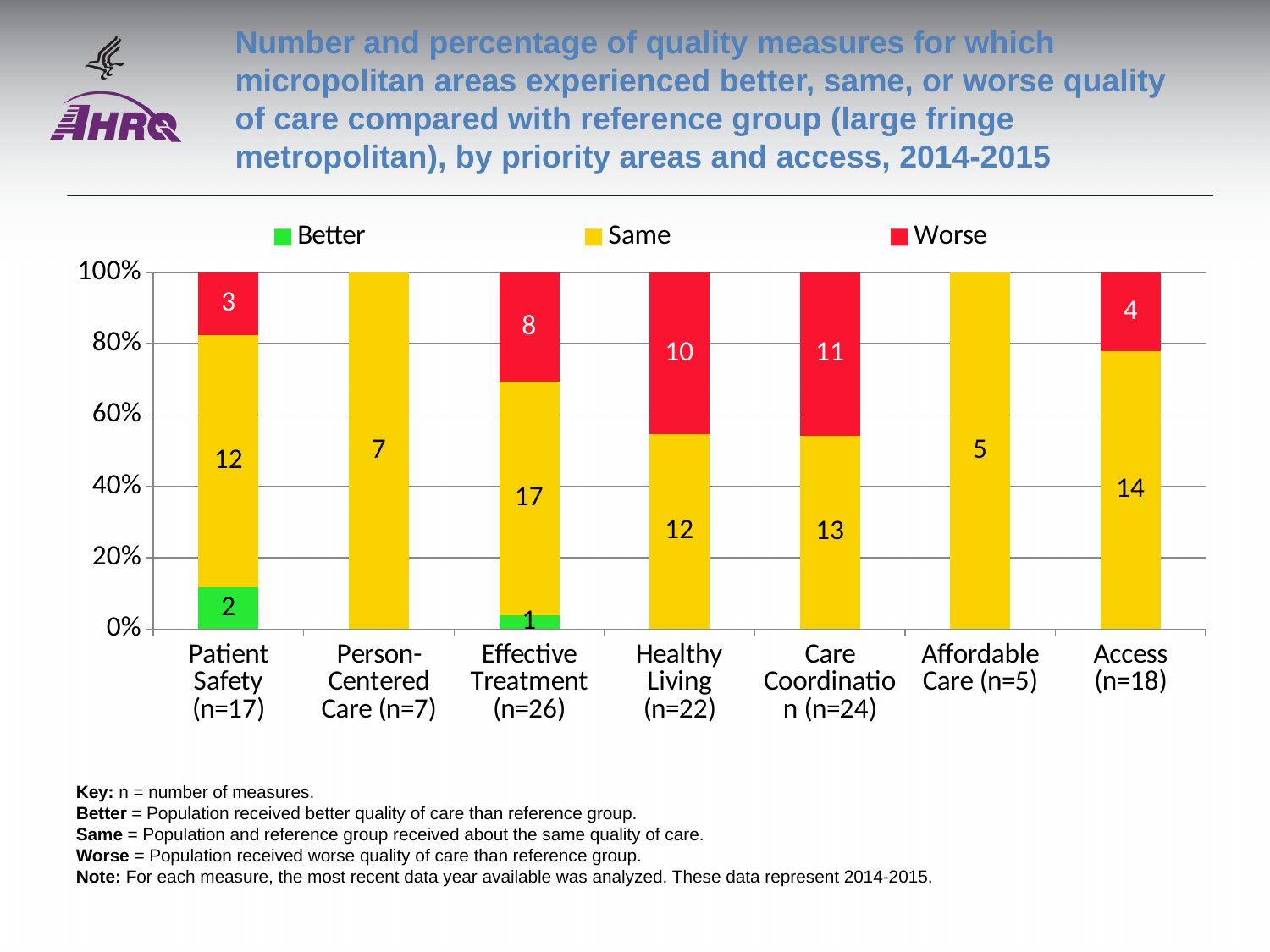
Which category has the lowest number of "Same" measures? Affordable Care (n=5) How many measures are labeled "Same" for Access (n=18)? 14 Which category has the highest number of "Worse" measures? Care Coordination (n=24) Which has more "Worse" measures, Healthy Living (n=22) or Access (n=18)? Healthy Living (n=22) How many measures are labeled "Better" for Patient Safety (n=17)? 2 What kind of chart is shown on the slide? Stacked bar chart How many categories are shown on the x axis? 7 How many measures are labeled "Worse" for Care Coordination (n=24)? 11 How many series does the legend list? 3 How many measures are labeled "Same" for Effective Treatment (n=26)? 17 Is the "Same" share of the Healthy Living (n=22) bar greater or less than 40%? greater What is the difference between the number of "Same" measures for Effective Treatment (n=26) and Healthy Living (n=22)? 5